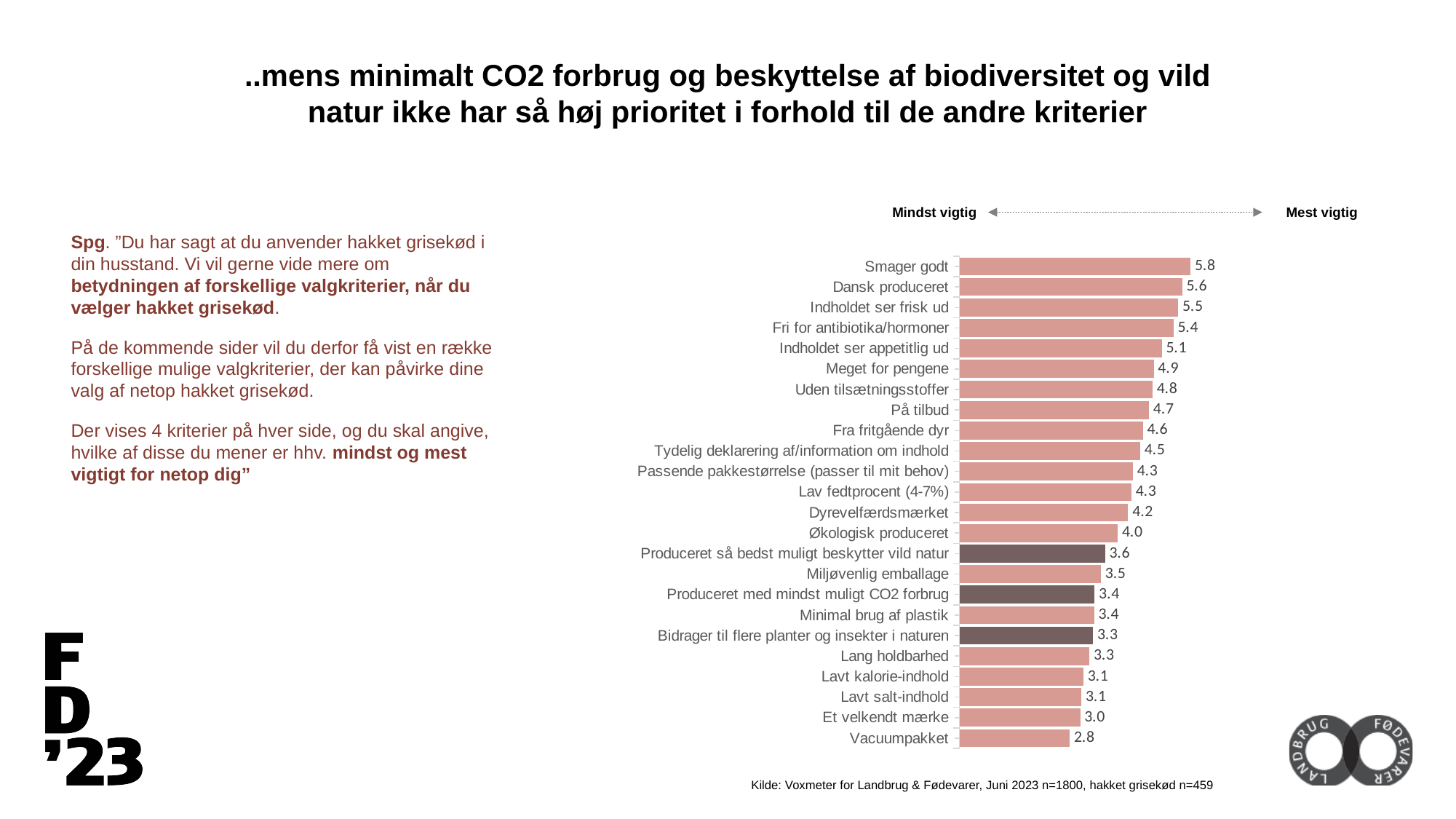
What is the value for "Produceret med mindst muligt CO2 forbrug"? 3.4 Which has a higher value, "Fra fritgående dyr" or "Dyrevelfærdsmærket"? Fra fritgående dyr Which category has the highest value? Smager godt How many bars are shown in a darker grey colour than the others? 3 How many categories are shown in the chart? 24 What is the value for "Smager godt"? 5.8 What is the value for "Økologisk produceret"? 4.0 What kind of chart is shown on the slide? bar chart What label appears at the right end of the arrow above the chart? Mest vigtig What is the difference between the values for "Smager godt" and "Vacuumpakket"? 3.0 What is the difference between the values for "Dansk produceret" and "Produceret så bedst muligt beskytter vild natur"? 2.0 Which category has the lowest value? Vacuumpakket